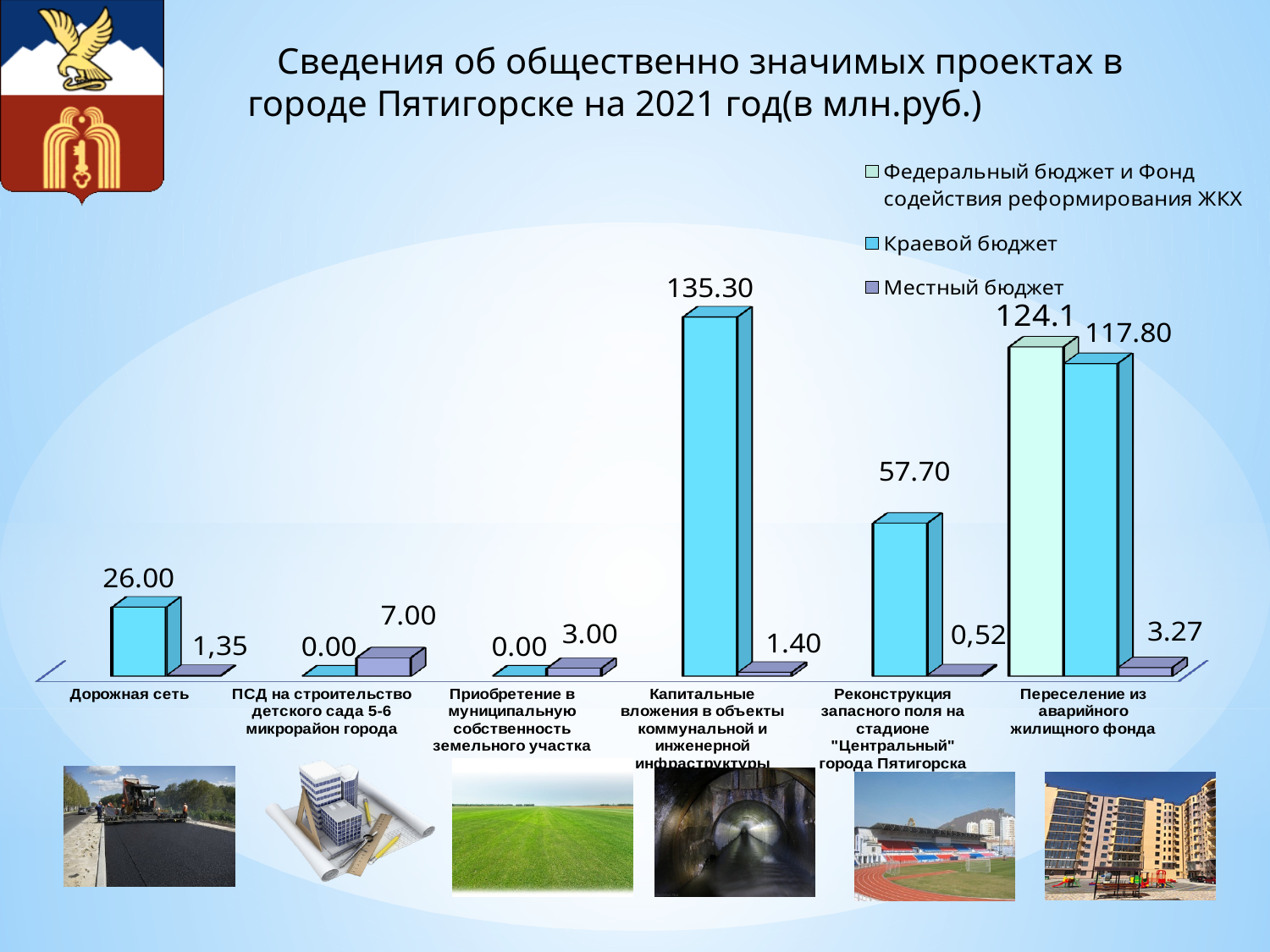
How many categories are shown on the x axis of the chart? 6 What is the difference between the Краевой бюджет values for Капитальные вложения в объекты коммунальной и инженерной инфраструктуры and Переселение из аварийного жилищного фонда? 17.50 What is the value of Федеральный бюджет и Фонд содействия реформирования ЖКХ for Переселение из аварийного жилищного фонда? 124.1 Which is larger: the Местный бюджет value for Приобретение в муниципальную собственность земельного участка or for Переселение из аварийного жилищного фонда? Переселение из аварийного жилищного фонда What kind of chart is shown on the slide? Bar chart What is the value of Краевой бюджет for ПСД на строительство детского сада 5-6 микрорайон города? 0.00 What is the value of Краевой бюджет for Капитальные вложения в объекты коммунальной и инженерной инфраструктуры? 135.30 Which category has the highest Местный бюджет value? ПСД на строительство детского сада 5-6 микрорайон города What is the value of Краевой бюджет for Реконструкция запасного поля на стадионе "Центральный" города Пятигорска? 57.70 What is the value of Местный бюджет for Дорожная сеть? 1,35 How many series does the legend list? 3 Which category has the highest Краевой бюджет value? Капитальные вложения в объекты коммунальной и инженерной инфраструктуры